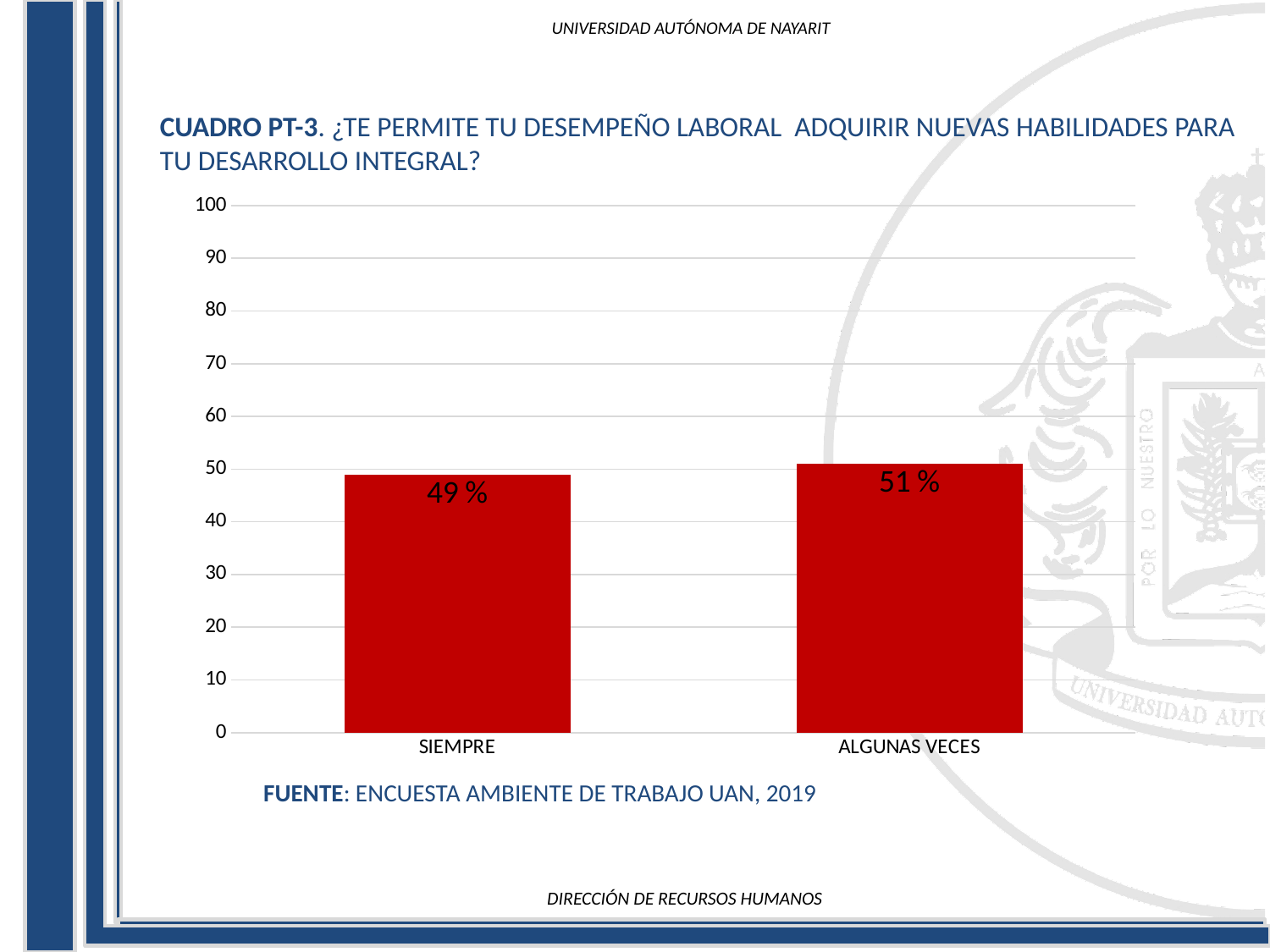
What colour are the bars in the chart? red What is the value for SIEMPRE? 49 % How many categories are shown on the x axis? 2 Which category has the lowest value? SIEMPRE Which category has the highest value? ALGUNAS VECES Which is larger, the value for SIEMPRE or the value for ALGUNAS VECES? ALGUNAS VECES Is the value for SIEMPRE greater or less than 50? less What is the difference between the values for ALGUNAS VECES and SIEMPRE? 2 % What is the maximum value shown on the vertical axis? 100 Is the value for ALGUNAS VECES greater or less than 50? greater What is the value for ALGUNAS VECES? 51 % What kind of chart is shown on the slide? bar chart